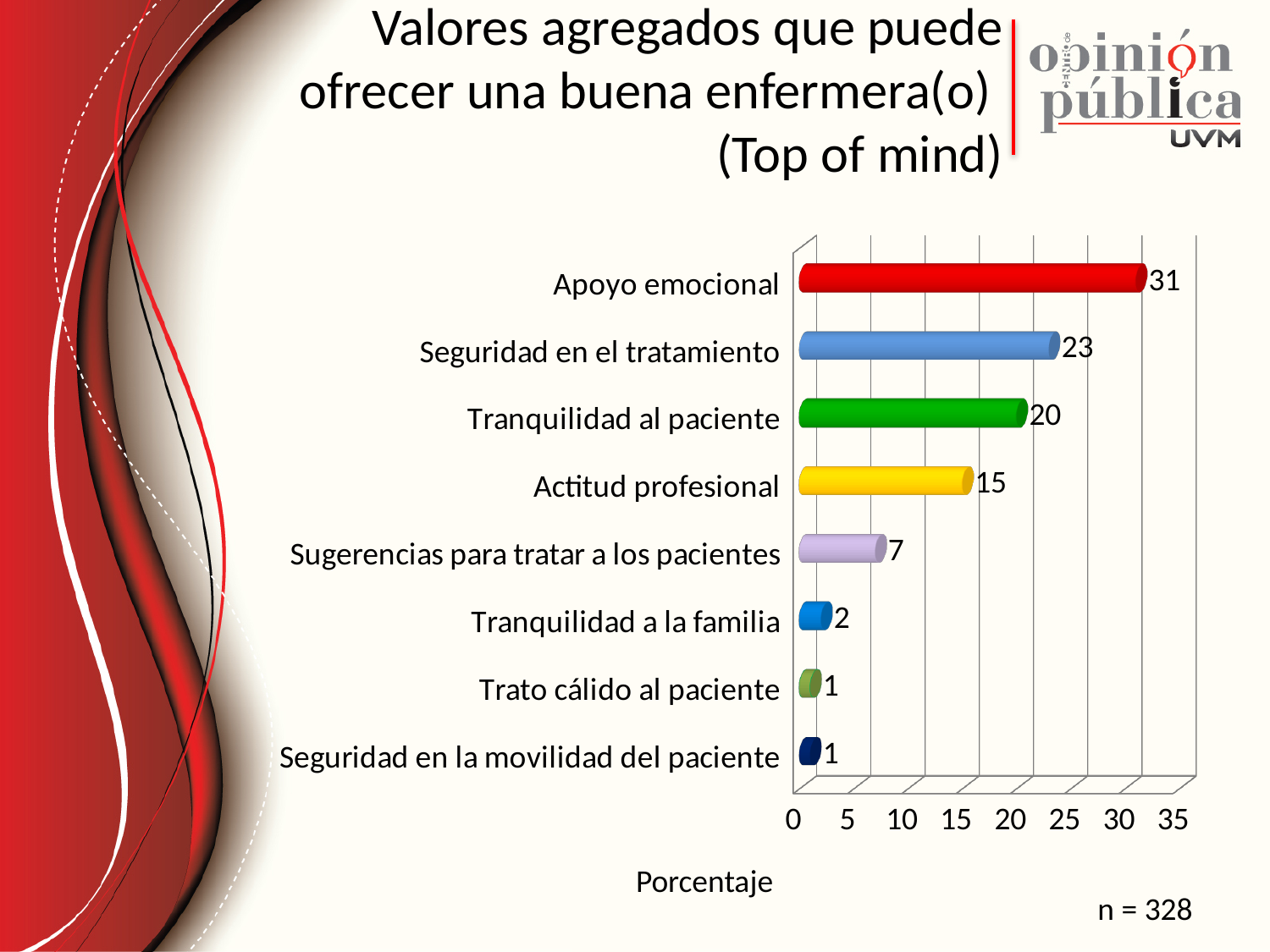
What is the value for Sugerencias para tratar a los pacientes? 7 What is the value for Apoyo emocional? 31 What is the label of the horizontal axis? Porcentaje What is the value for Seguridad en el tratamiento? 23 What is the difference between the values for Apoyo emocional and Seguridad en el tratamiento? 8 Which is larger, the value for Actitud profesional or the value for Sugerencias para tratar a los pacientes? Actitud profesional What is the difference between the values for Tranquilidad al paciente and Actitud profesional? 5 What kind of chart is shown on the slide? bar chart Which category has the highest value? Apoyo emocional How many categories are shown in the chart? 8 What is the value for Tranquilidad a la familia? 2 Is the value for Tranquilidad al paciente greater or less than 15? greater